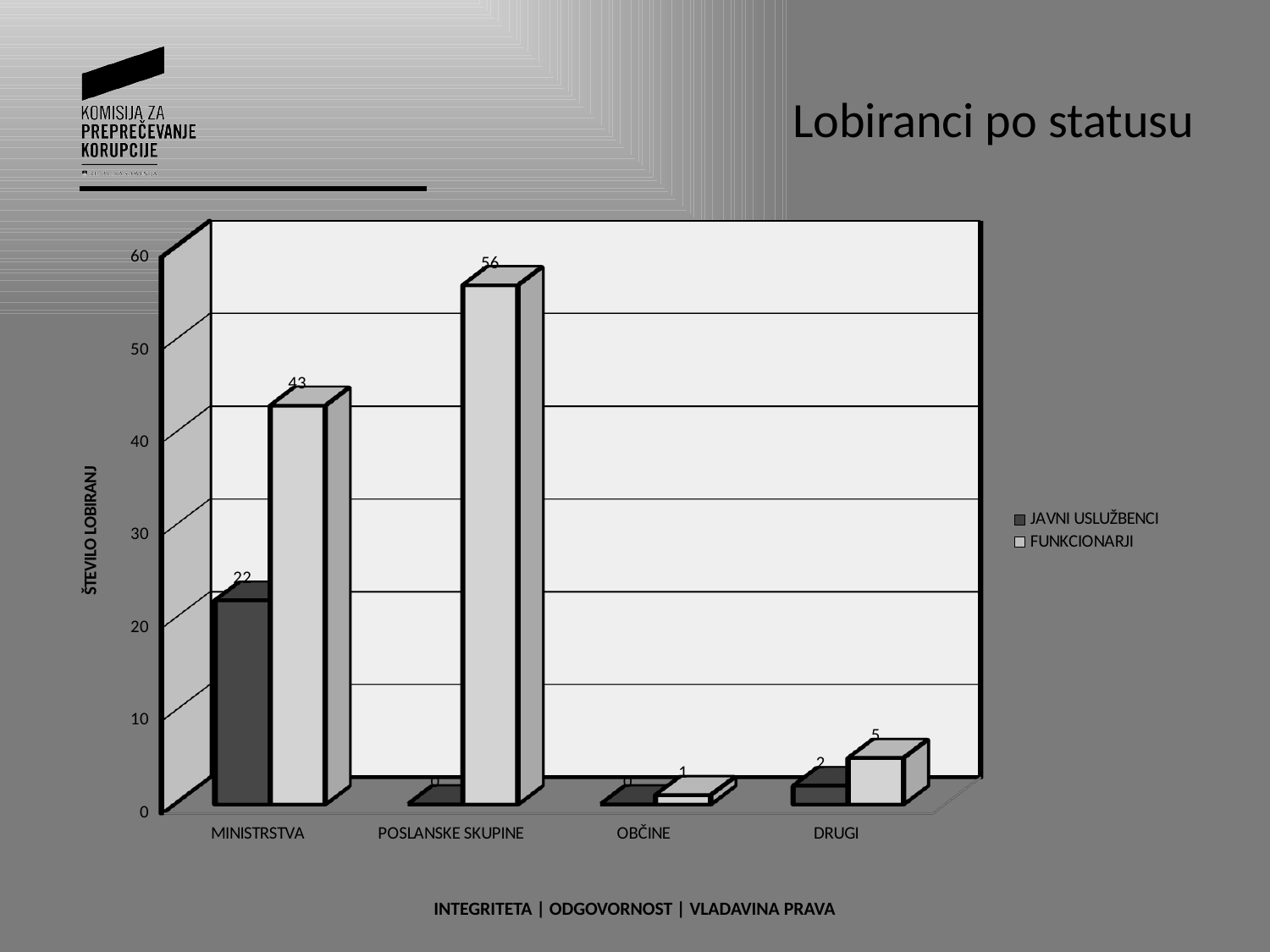
What is the difference between the FUNKCIONARJI and JAVNI USLUŽBENCI values for MINISTRSTVA? 21 What is the value for FUNKCIONARJI in the DRUGI category? 5 What is the value for FUNKCIONARJI in the MINISTRSTVA category? 43 What is the title of the chart? Lobiranci po statusu What is the value for JAVNI USLUŽBENCI in the DRUGI category? 2 How many categories are shown on the x axis? 4 Which category has the lowest FUNKCIONARJI value? OBČINE What is the value for JAVNI USLUŽBENCI in the MINISTRSTVA category? 22 What is the value for FUNKCIONARJI in the POSLANSKE SKUPINE category? 56 Which category has the highest FUNKCIONARJI value? POSLANSKE SKUPINE How many series does the legend list? 2 Which is larger: the FUNKCIONARJI value for MINISTRSTVA or for POSLANSKE SKUPINE? POSLANSKE SKUPINE